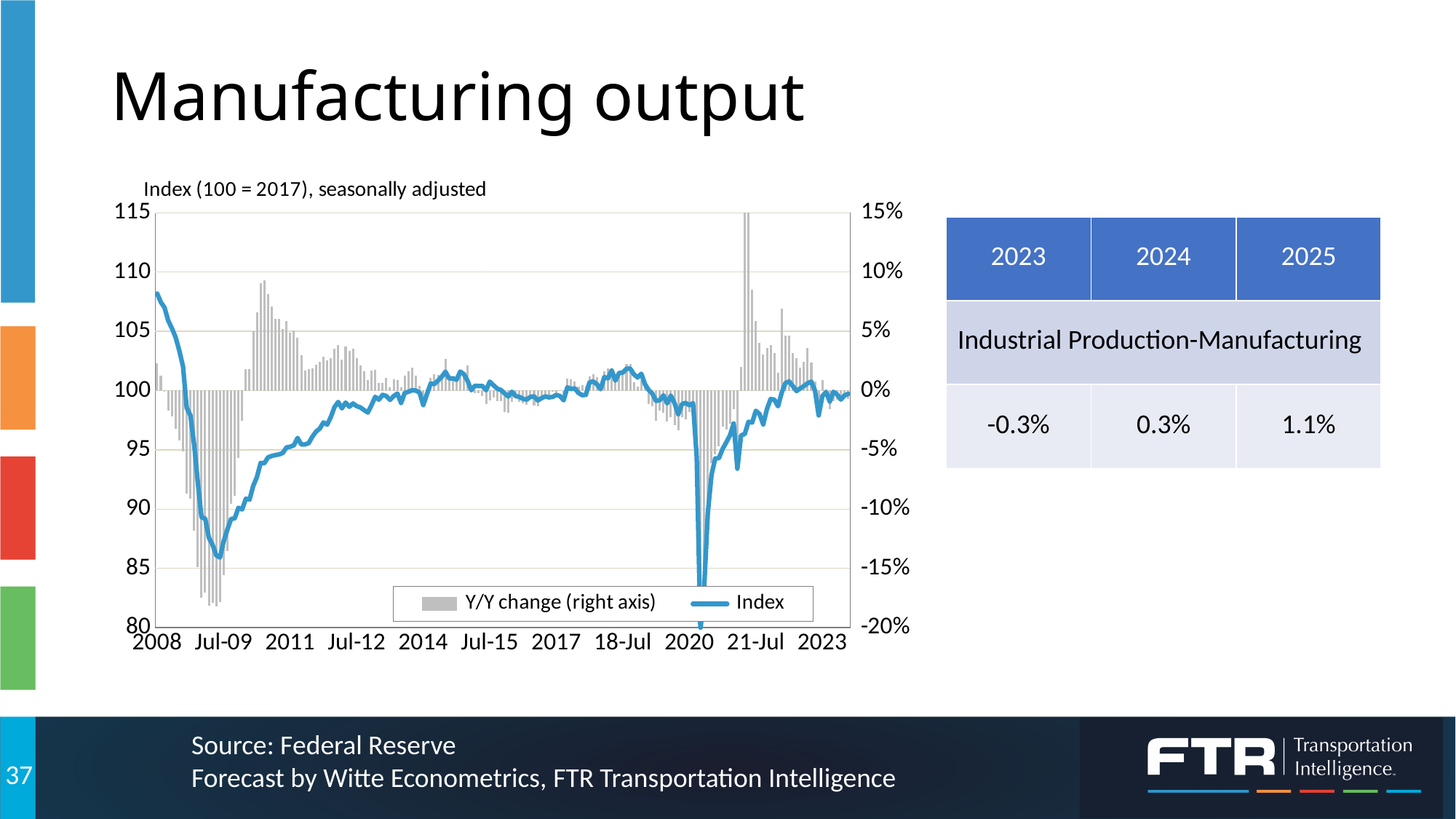
What is the subtitle shown above the chart? Index (100 = 2017), seasonally adjusted Which is larger, the Index value at the start of 2008 or the Index value at 2023? 2008 Is the lowest Y/Y change value in 2020 greater or less than -15%? less Is the highest Y/Y change value around 21-Jul greater or less than 10%? greater How many series does the chart legend list? 2 Is the Index value at the start of 2008 greater or less than 105? greater Does the Index rise or fall between Jul-09 and 2011? rise What kind of chart is shown on the slide? A combination bar and line chart Does the Index rise or fall between 2008 and Jul-09? fall Which series is plotted on the right axis according to the legend? Y/Y change